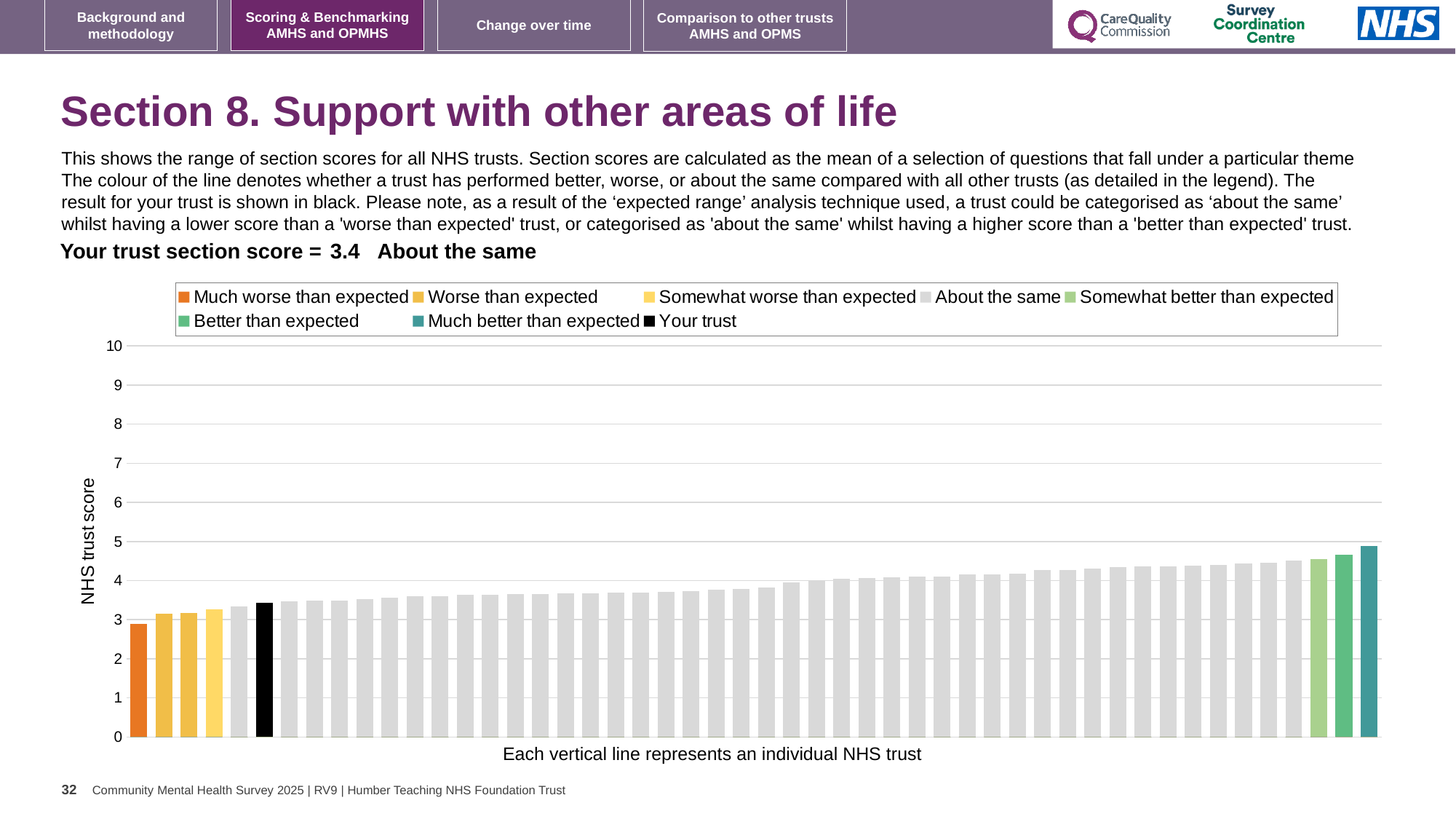
Is the value for the tallest bar greater or less than 4? greater Which legend category does the shortest bar belong to? Much worse than expected What kind of chart is shown on the slide? bar chart Which category is your trust's section score placed in? About the same How many bars are coloured as 'Much worse than expected'? 1 Which legend category does the tallest bar belong to? Much better than expected How many entries does the chart legend list? 8 Do the bar values rise or fall from left to right along the x axis? rise What is the section score for your trust? 3.4 Is the value for your trust greater or less than 4? less Which is larger: the value for your trust or the value of the tallest bar? the tallest bar What is the title of the vertical axis? NHS trust score